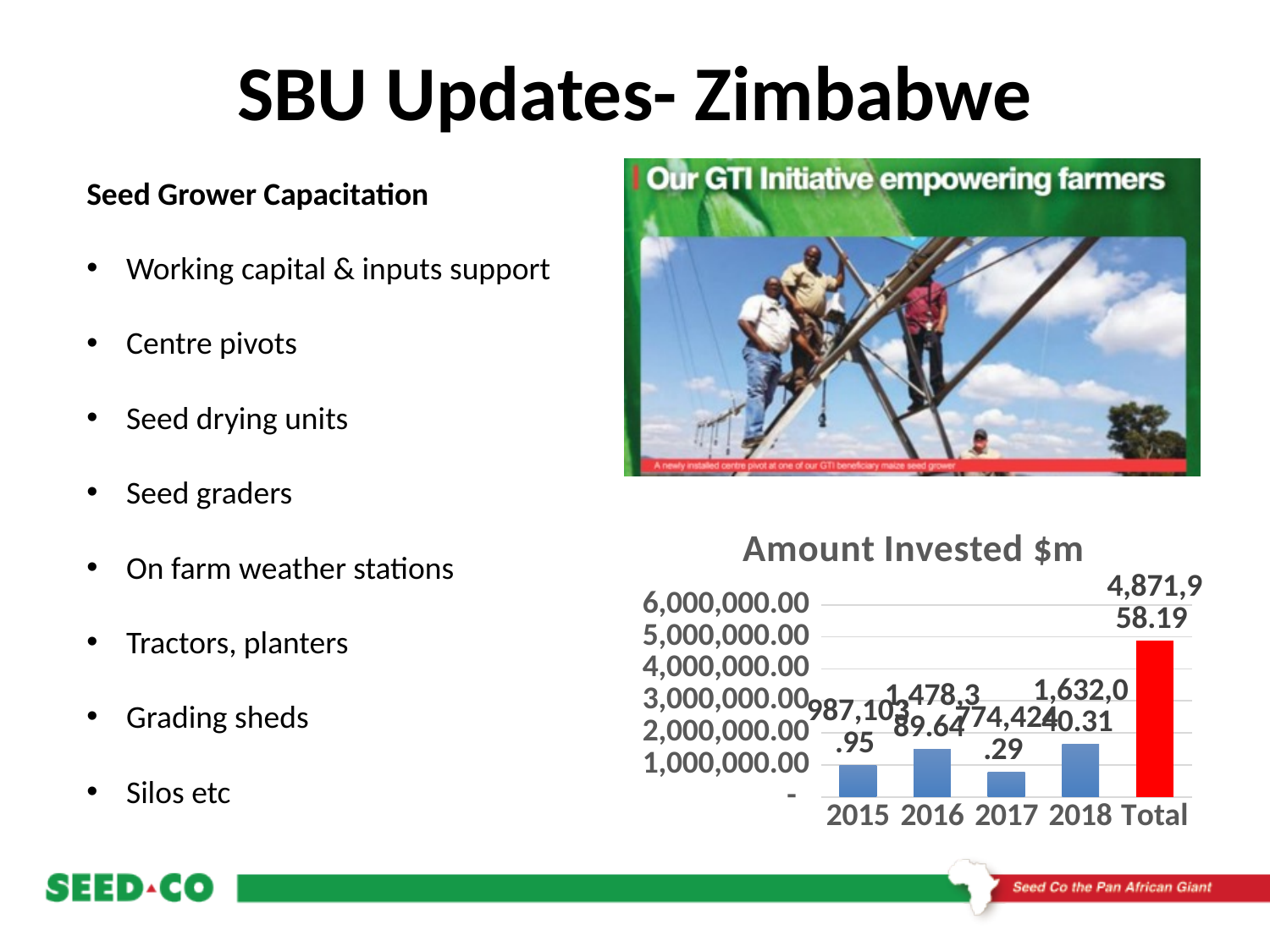
What kind of chart is the "Amount Invested $m" chart? bar chart In the "Amount Invested $m" chart, what is the value for 2017? 774,424.29 In the "Amount Invested $m" chart, is the value for 2016 greater or less than 1,000,000.00? greater In the "Amount Invested $m" chart, is the value for Total greater or less than 4,000,000.00? greater In the "Amount Invested $m" chart, what colour is the Total bar? red In the "Amount Invested $m" chart, what is the value for Total? 4,871,958.19 In the "Amount Invested $m" chart, which of the years 2015 to 2018 has the highest value? 2018 In the "Amount Invested $m" chart, which of the years 2015 to 2018 has the lowest value? 2017 In the "Amount Invested $m" chart, which is larger, the value for 2016 or the value for 2017? 2016 In the "Amount Invested $m" chart, what is the value for 2018? 1,632,040.31 What is the title of the chart on the slide? Amount Invested $m How many categories are shown on the x axis of the "Amount Invested $m" chart? 5